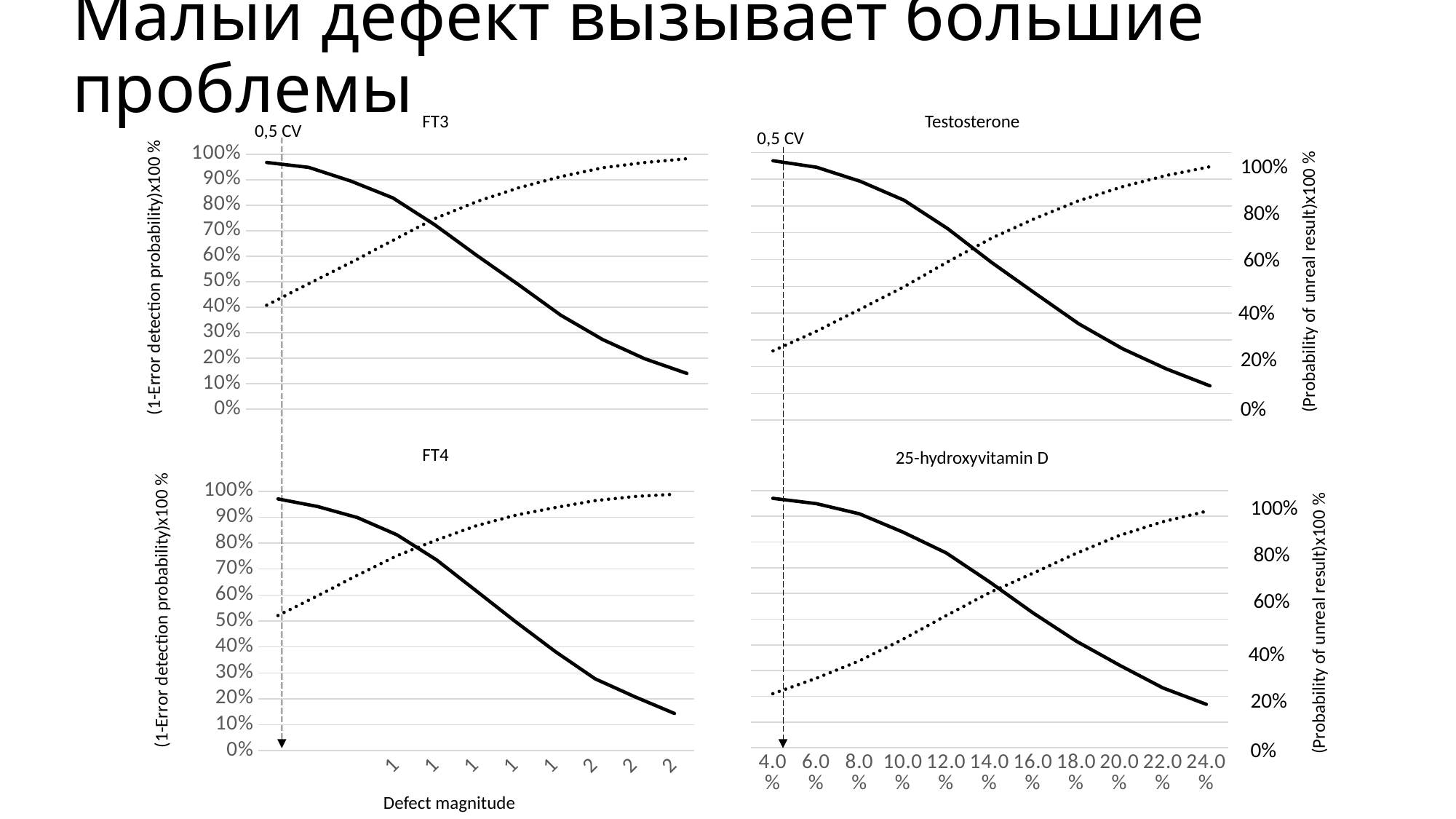
How many charts are shown on the slide? 4 In the Testosterone chart, is the starting value of the dotted line greater or less than 40%? less In the Testosterone chart, does the solid line rise or fall as defect magnitude increases along the x axis? fall In the 25-hydroxyvitamin D chart, does the dotted line rise or fall along the x axis? rise In the FT3 chart, is the starting value of the solid line greater or less than 90%? greater In the FT3 chart, is the final value of the solid line greater or less than 20%? less What is the x-axis title shown under the FT4 chart? Defect magnitude What is the title of the chart in the bottom-left position of the slide? FT4 What kind of chart is the FT3 chart? line chart How many x-axis tick labels does the 25-hydroxyvitamin D chart show? 11